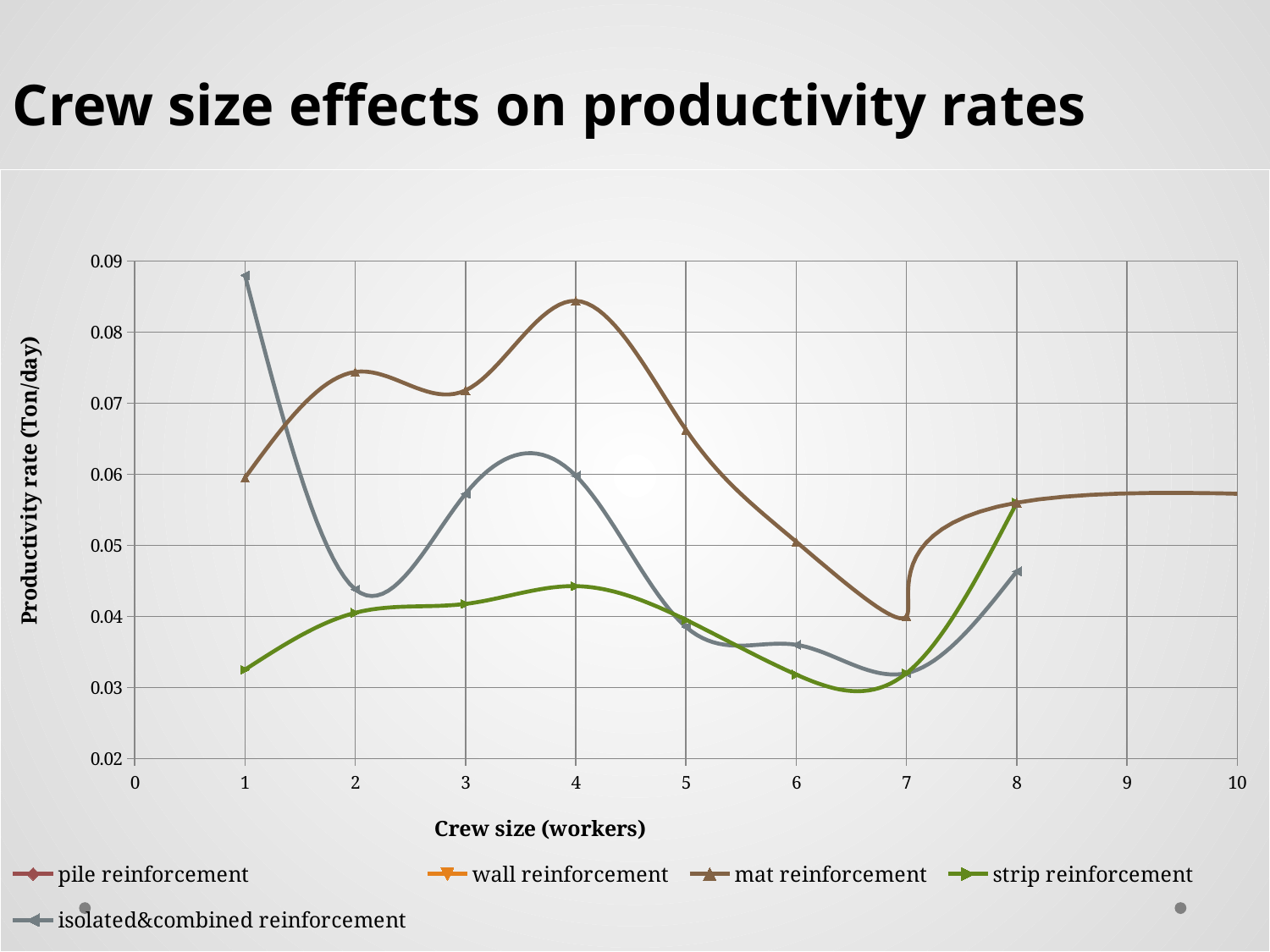
At crew size 4, which is larger: mat reinforcement or isolated&combined reinforcement? mat reinforcement How many series does the legend list? 5 Is the value for strip reinforcement at crew size 1 greater or less than 0.04? less What kind of chart is shown on the slide? line chart Does the mat reinforcement line rise or fall from crew size 4 to crew size 7? fall What is the title of the chart? Crew size effects on productivity rates Is the value for mat reinforcement at crew size 7 greater or less than 0.05? less Is the value for mat reinforcement at crew size 4 greater or less than 0.08? greater Which series has the highest productivity rate at crew size 2? mat reinforcement Which series has the lowest productivity rate at crew size 6? strip reinforcement What is the label of the vertical axis? Productivity rate (Ton/day)